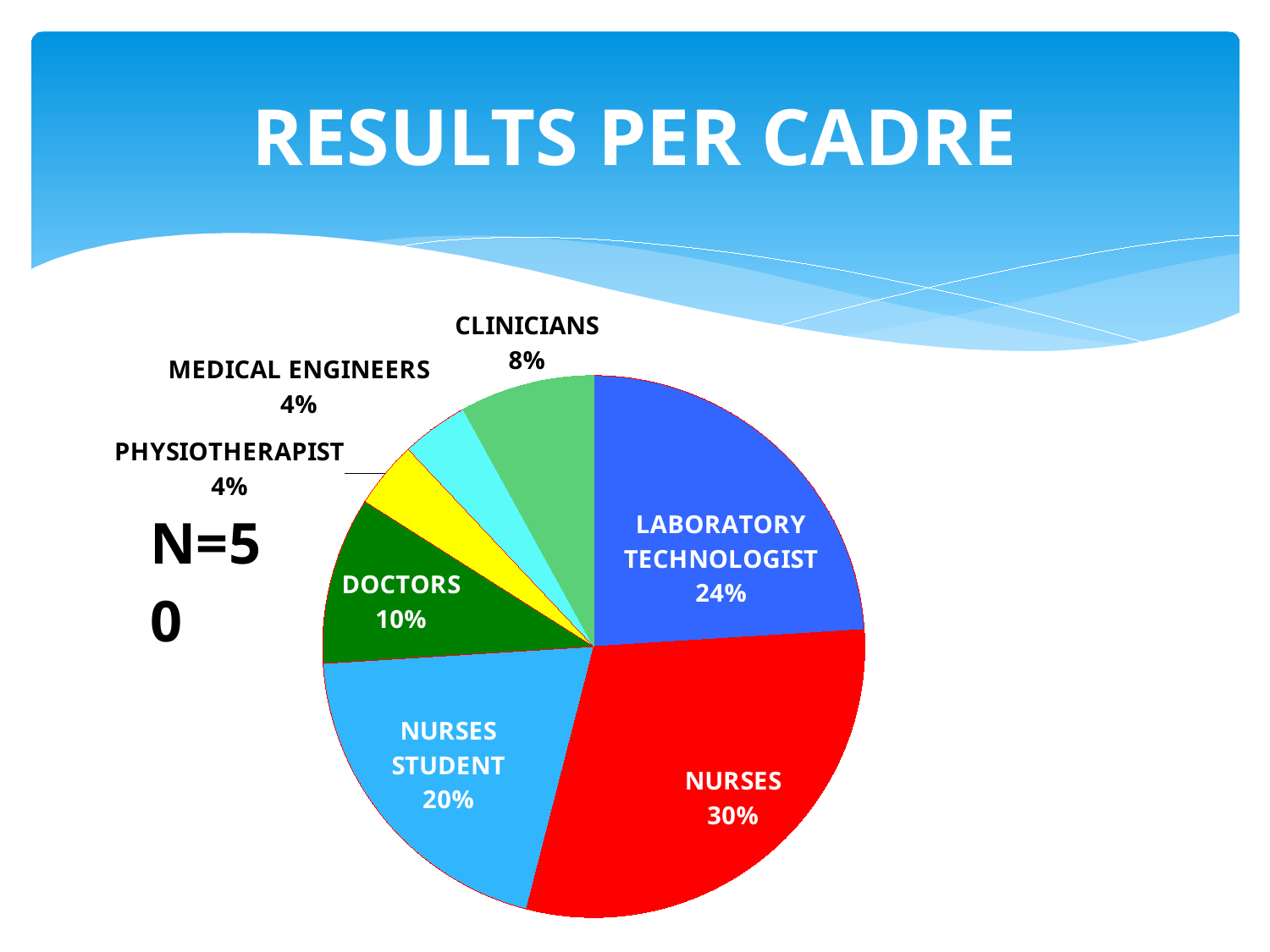
What percentage of the pie is labelled NURSES STUDENT? 20% How many cadres (slices) are shown in the pie chart? 7 Which slice is larger, NURSES STUDENT or DOCTORS? NURSES STUDENT What kind of chart is shown on the slide? Pie chart What percentage of the pie is labelled NURSES? 30% What is the difference in percentage points between NURSES and LABORATORY TECHNOLOGIST? 6% What percentage of the pie is labelled DOCTORS? 10% What percentage of the pie is labelled CLINICIANS? 8% What colour is the NURSES slice? Red What percentage of the pie is labelled LABORATORY TECHNOLOGIST? 24% Which cadre has the largest slice of the pie? NURSES What is the title of the slide? RESULTS PER CADRE